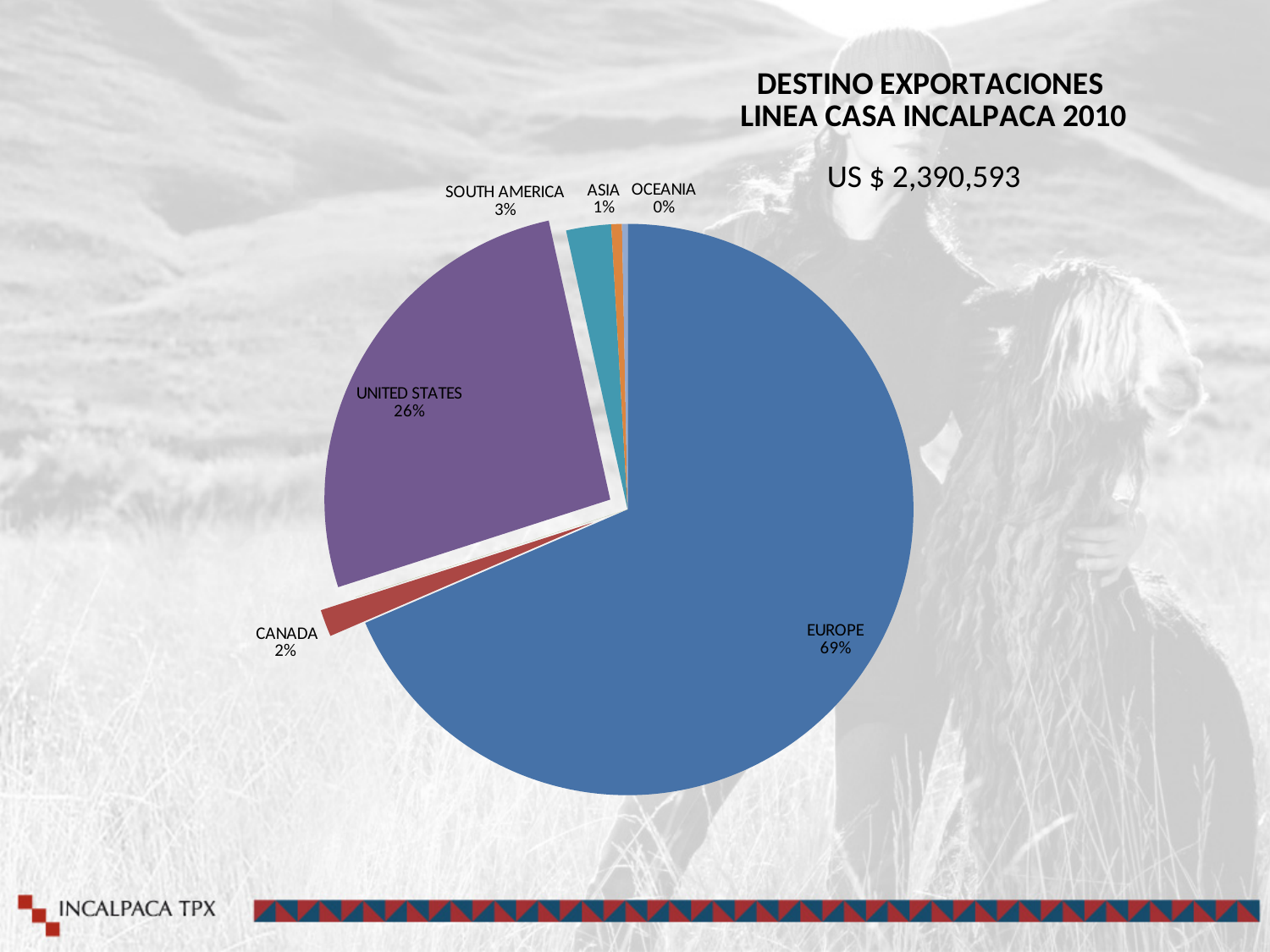
What share of exports went to the United States? 26% What share of exports went to Asia? 1% Which has a larger share, South America or Canada? South America What share of exports went to Europe? 69% What total export value is shown on the slide? US $ 2,390,593 Which destination has the smallest share of exports? Oceania What is the difference in percentage points between the Europe and United States shares? 43 How many destination categories are shown in the pie chart? 6 What kind of chart is shown on the slide? pie chart Which destination has the largest share of exports? Europe